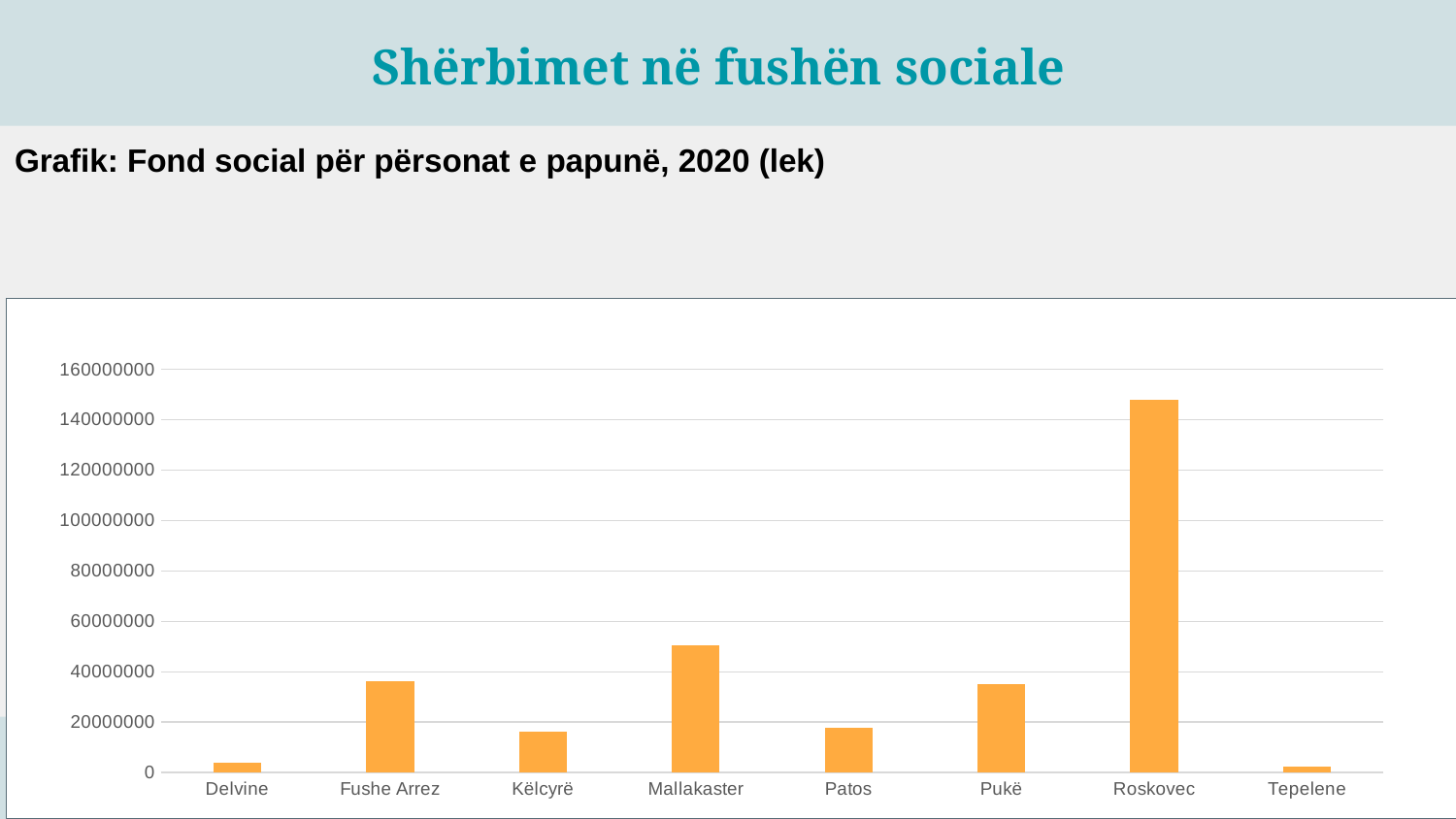
Which municipality has the highest value in the chart? Roskovec Which municipality has the lowest value in the chart? Tepelene Is the value for Fushe Arrez greater or less than 40000000? less Is the value for Këlcyrë greater or less than 20000000? less What is the title of the chart given above it on the slide? Fond social për përsonat e papunë, 2020 (lek) Is the value for Pukë greater or less than 20000000? greater Which has a larger value, Mallakaster or Fushe Arrez? Mallakaster How many municipalities (categories) are shown on the x axis of the chart? 8 What kind of chart is shown on the slide? bar chart Which has a larger value, Patos or Pukë? Pukë